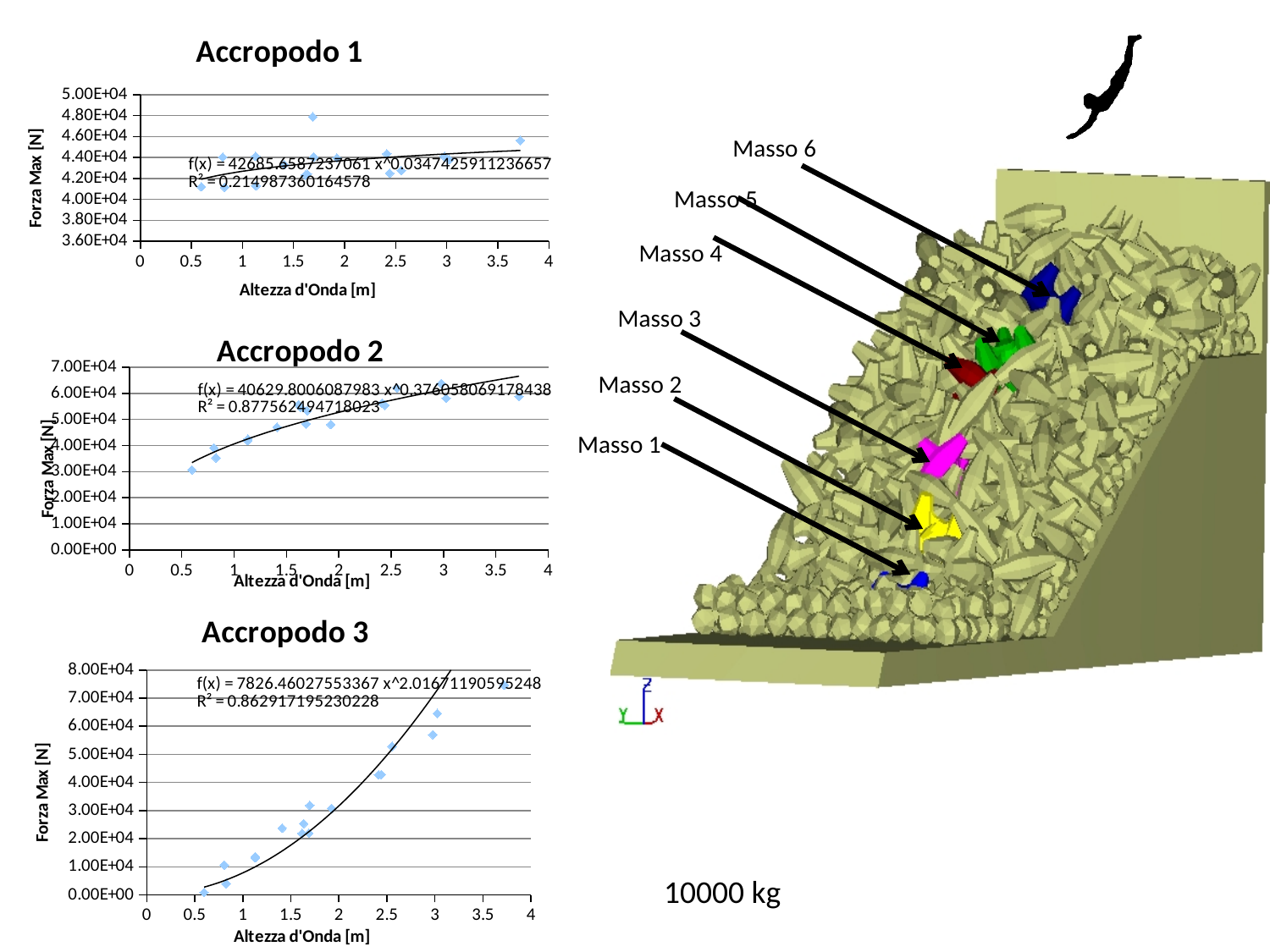
What kind of chart is the Accropodo 1 chart? scatter chart In the Accropodo 2 chart, is the Forza Max value at the largest wave height (about 3.7 m) greater or less than 5.00E+04? greater In the Accropodo 2 chart, do the Forza Max values generally rise or fall as Altezza d'Onda increases? rise In the Accropodo 3 chart, is the Forza Max value at the smallest wave height (about 0.6 m) greater or less than 1.00E+04? less What R² value is shown on the Accropodo 2 chart? 0.877562494718023 In the Accropodo 3 chart, is the Forza Max value at the largest wave height (about 3.7 m) greater or less than 7.00E+04? greater In the Accropodo 2 chart, which is larger: the Forza Max value at about 0.6 m wave height or at about 1.7 m wave height? 1.7 m In the Accropodo 3 chart, do the Forza Max values generally rise or fall as Altezza d'Onda increases? rise What is the x-axis label of the Accropodo 3 chart? Altezza d'Onda [m] In the Accropodo 3 chart, which is larger: the Forza Max value at about 3.0 m wave height or at about 2.5 m wave height? 3.0 m